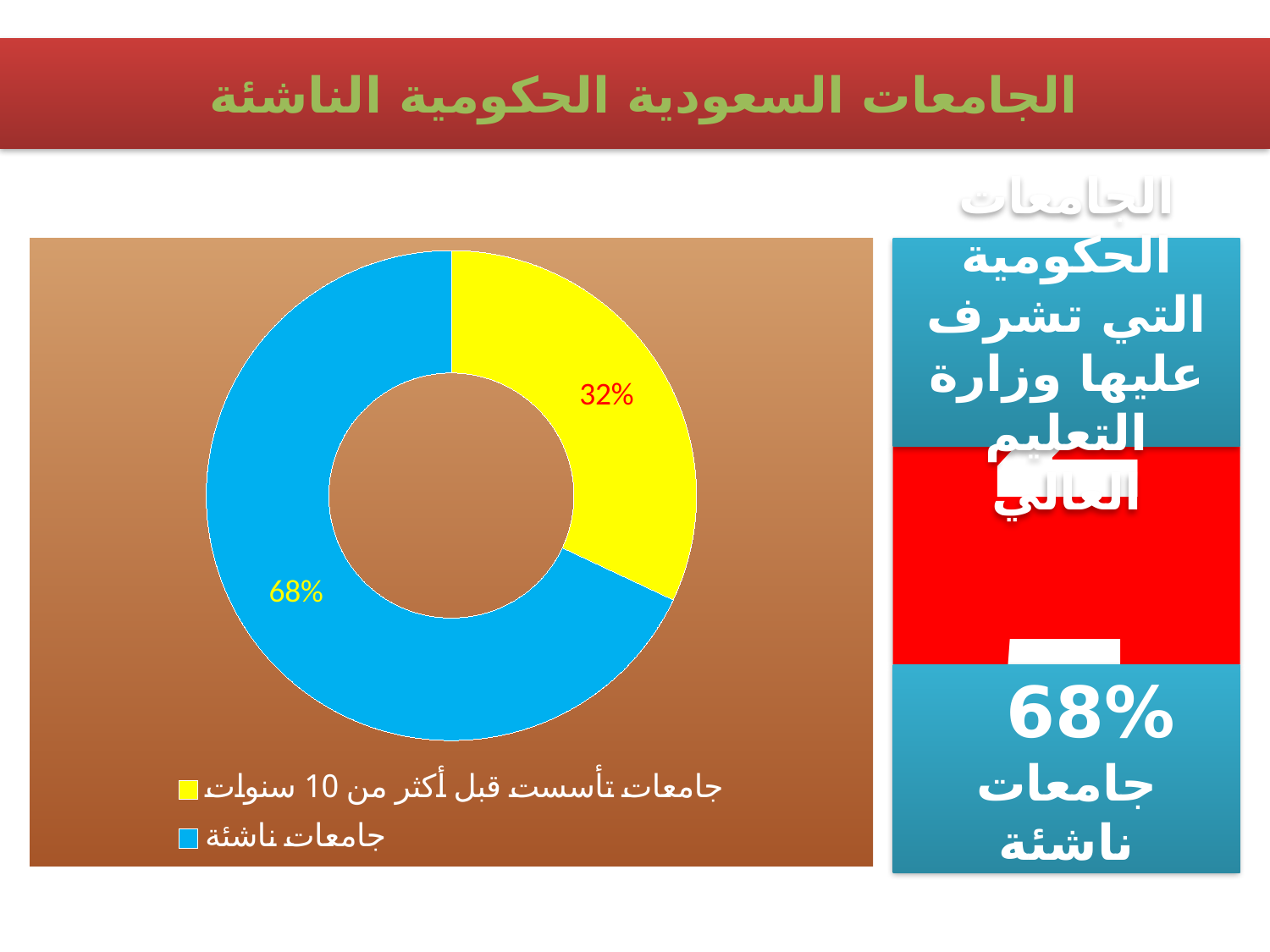
What colour is the slice for جامعات تأسست قبل أكثر من 10 سنوات? Yellow What colour is the slice for جامعات ناشئة? Blue What percentage is shown for جامعات ناشئة? 68% Which is larger: the share for جامعات ناشئة or the share for جامعات تأسست قبل أكثر من 10 سنوات? جامعات ناشئة Which category has the smallest share of the doughnut chart? جامعات تأسست قبل أكثر من 10 سنوات What percentage is shown for جامعات تأسست قبل أكثر من 10 سنوات? 32% How many entries does the legend list? 2 How many categories are shown in the doughnut chart? 2 What kind of chart is shown on the slide? Doughnut chart Which category has the largest share of the doughnut chart? جامعات ناشئة What is the difference in percentage points between جامعات ناشئة and جامعات تأسست قبل أكثر من 10 سنوات? 36 What is the total of the two percentages shown in the doughnut chart? 100%